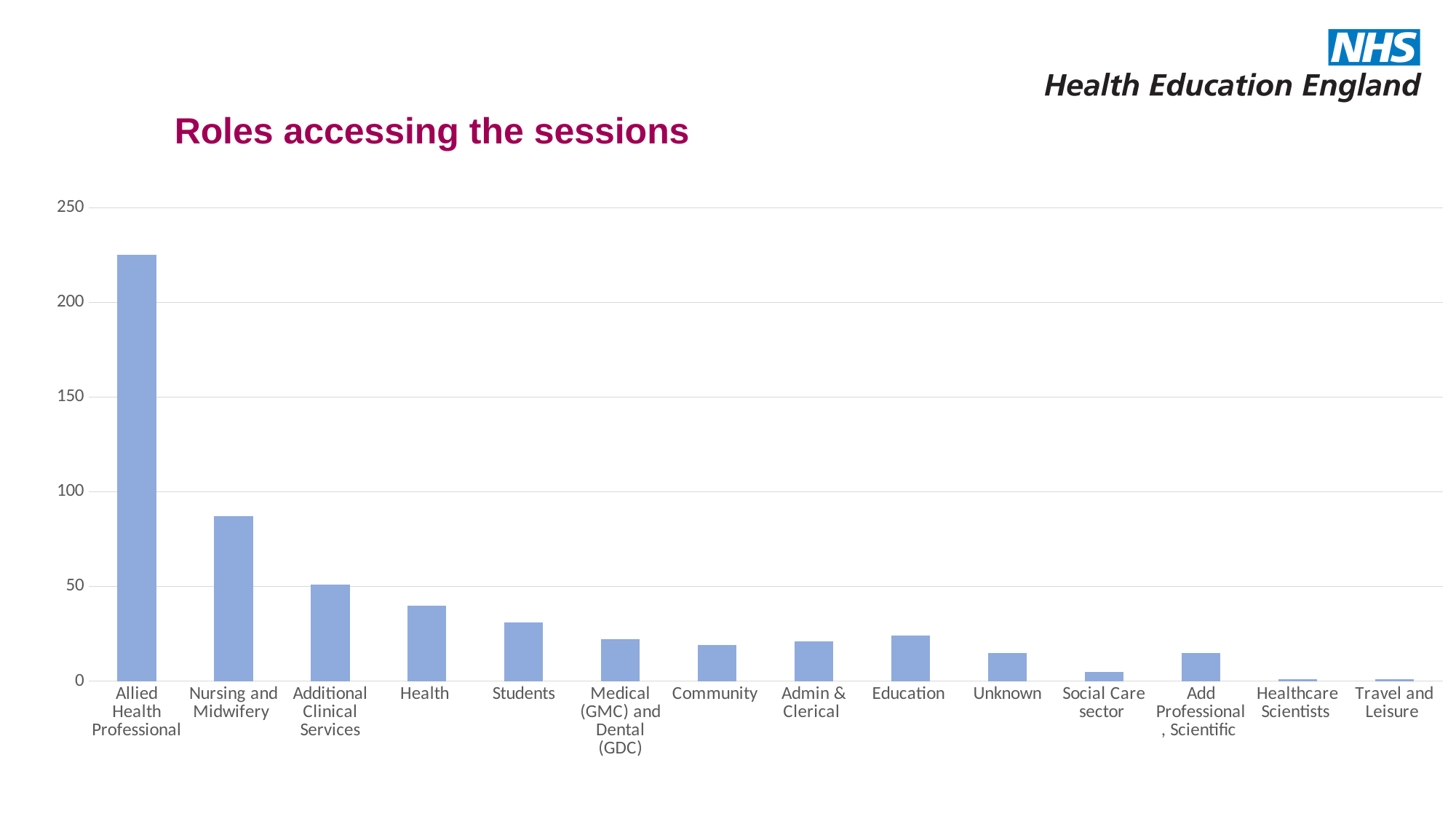
Which is larger, the value for Nursing and Midwifery or the value for Additional Clinical Services? Nursing and Midwifery How many role categories are shown on the x axis of the chart? 14 What kind of chart is shown on the slide? bar chart What is the title of the slide's chart? Roles accessing the sessions Which is larger, the value for Education or the value for Unknown? Education Is the value for Social Care sector greater or less than 50? less Do the bar values generally rise or fall from left to right along the x axis? fall Is the value for Allied Health Professional greater or less than 200? greater Which is larger, the value for Health or the value for Students? Health Which role has the highest value in the chart? Allied Health Professional Is the value for Nursing and Midwifery greater or less than 100? less